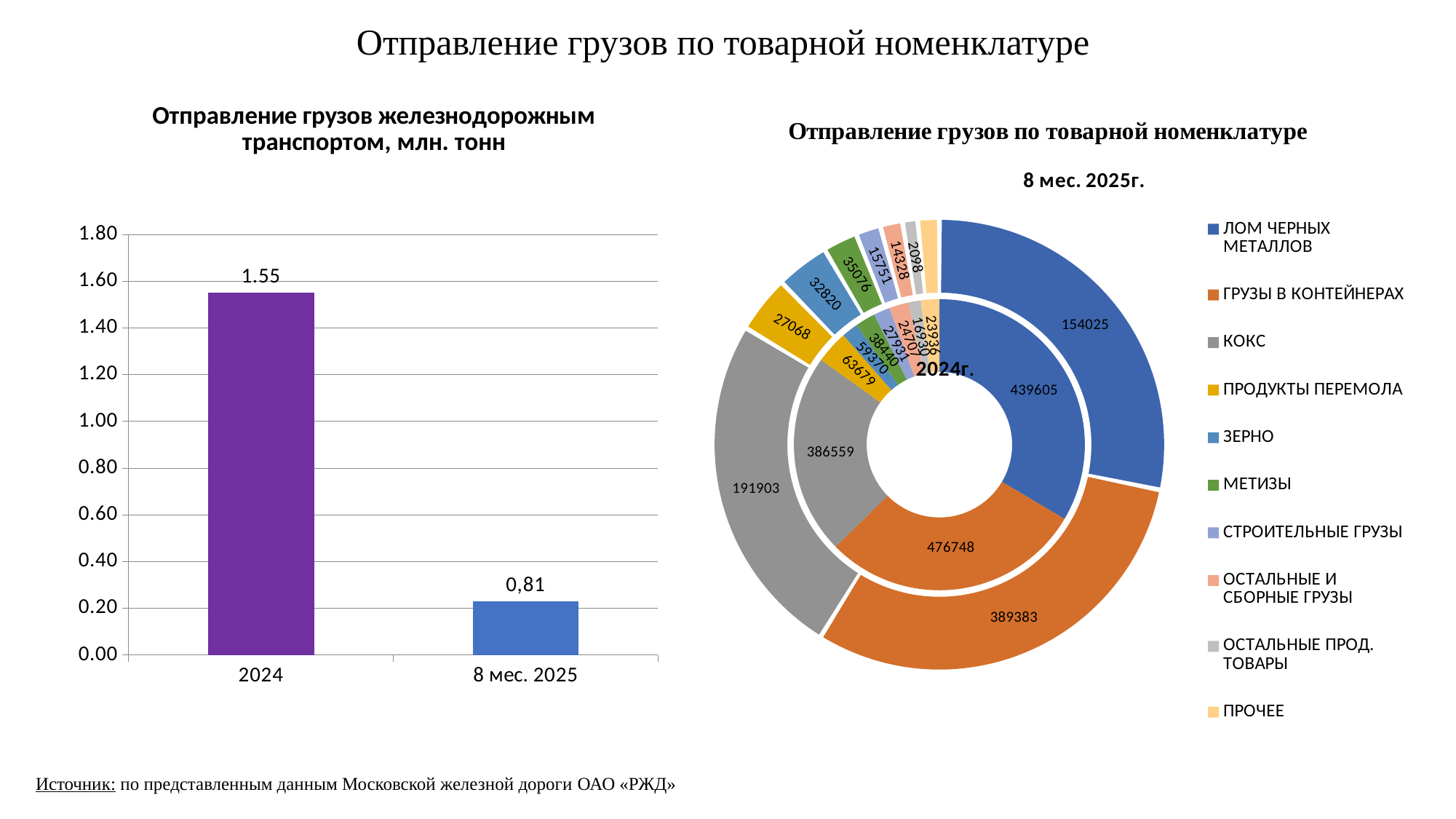
On the left chart 'Отправление грузов железнодорожным транспортом, млн. тонн', which category has the higher value? 2024 On the right chart 'Отправление грузов по товарной номенклатуре', what is the value for ГРУЗЫ В КОНТЕЙНЕРАХ in the outer ring (8 мес. 2025г.)? 389383 On the right chart 'Отправление грузов по товарной номенклатуре', what is the difference between ГРУЗЫ В КОНТЕЙНЕРАХ and ЛОМ ЧЕРНЫХ МЕТАЛЛОВ in the outer ring (8 мес. 2025г.)? 235358 On the left chart 'Отправление грузов железнодорожным транспортом, млн. тонн', what value is labelled for 8 мес. 2025? 0,81 On the right chart 'Отправление грузов по товарной номенклатуре', which category has the largest value in the outer ring (8 мес. 2025г.)? ГРУЗЫ В КОНТЕЙНЕРАХ What kind of chart is the left chart 'Отправление грузов железнодорожным транспортом, млн. тонн'? bar chart On the left chart 'Отправление грузов железнодорожным транспортом, млн. тонн', what is the value for 2024? 1.55 On the right chart 'Отправление грузов по товарной номенклатуре', which is larger in the inner ring (2024г.): ПРОДУКТЫ ПЕРЕМОЛА or ЗЕРНО? ПРОДУКТЫ ПЕРЕМОЛА On the right chart 'Отправление грузов по товарной номенклатуре', what is the value for ЛОМ ЧЕРНЫХ МЕТАЛЛОВ in the inner ring (2024г.)? 439605 How many categories are shown on the left chart 'Отправление грузов железнодорожным транспортом, млн. тонн'? 2 On the right chart 'Отправление грузов по товарной номенклатуре', what is the value for КОКС in the outer ring (8 мес. 2025г.)? 191903 How many categories does the legend of the right chart 'Отправление грузов по товарной номенклатуре' list? 10